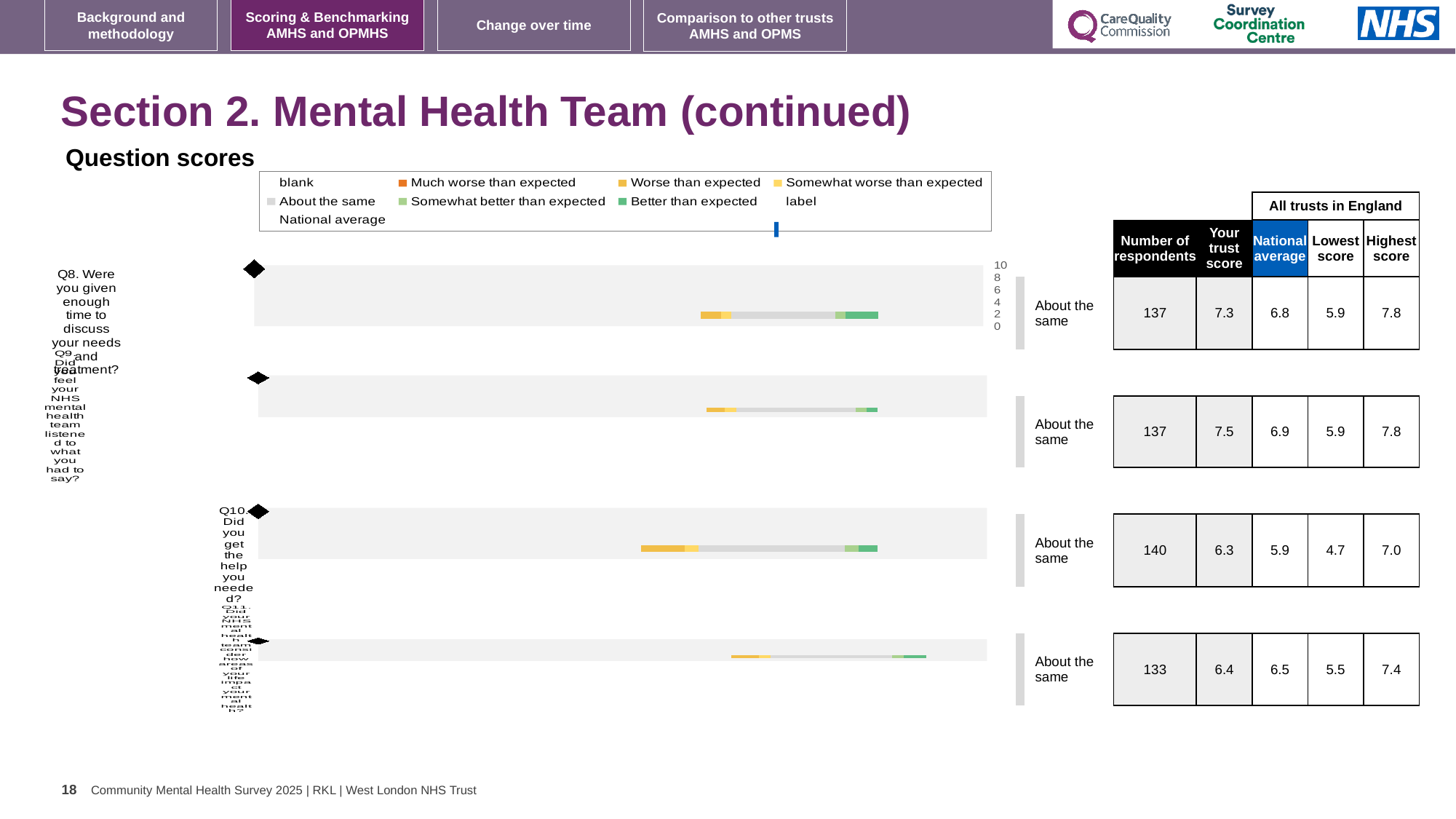
For the Q9 chart, what is the National average score in the table? 6.9 How many question charts (Q8 to Q11) are shown on the slide? 4 Which question (Q8, Q9, Q10 or Q11) has the lowest 'Your trust score'? Q10 What colour represents 'Better than expected' in the legend? green For the Q10 chart, what is the difference between the Highest score and the Lowest score? 2.3 For the Q11 chart, which is larger: Your trust score or the National average? National average For the Q8 chart, what is 'Your trust score' in the table? 7.3 For the Q10 chart, what is the Number of respondents? 140 For the Q11 chart, what is the Highest score among all trusts in England? 7.4 What kind of chart is used to show the Q8 question score? bar chart What benchmark label is shown next to each of the four question charts? About the same How many entries does the legend above the charts list? 9